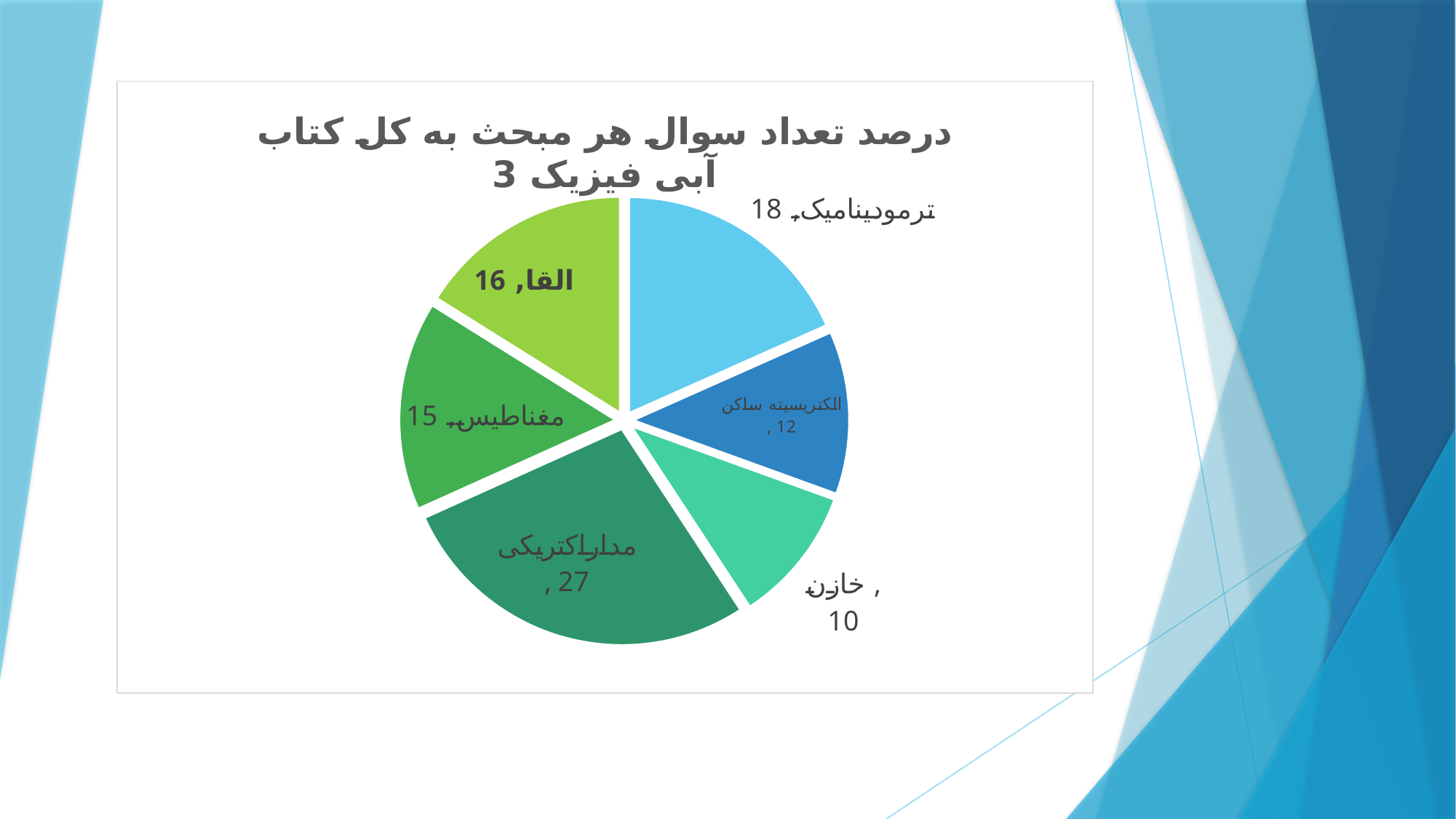
Which topic has the smallest slice in the pie chart? خازن Which is larger, the value for القا or the value for مغناطیس? القا What is the title of the chart? درصد تعداد سوال هر مبحث به کل کتاب آبی فیزیک 3 What is the value for خازن in the pie chart? 10 What is the difference between the values for مدار الکتریکی and ترمودینامیک? 9 What is the value for مدار الکتریکی in the pie chart? 27 What is the value for مغناطیس in the pie chart? 15 What is the value for ترمودینامیک in the pie chart? 18 How many slices does the pie chart have? 6 Which topic has the largest slice in the pie chart? مدار الکتریکی What is the value for الکتریسیته ساکن in the pie chart? 12 What kind of chart is shown on the slide? pie chart